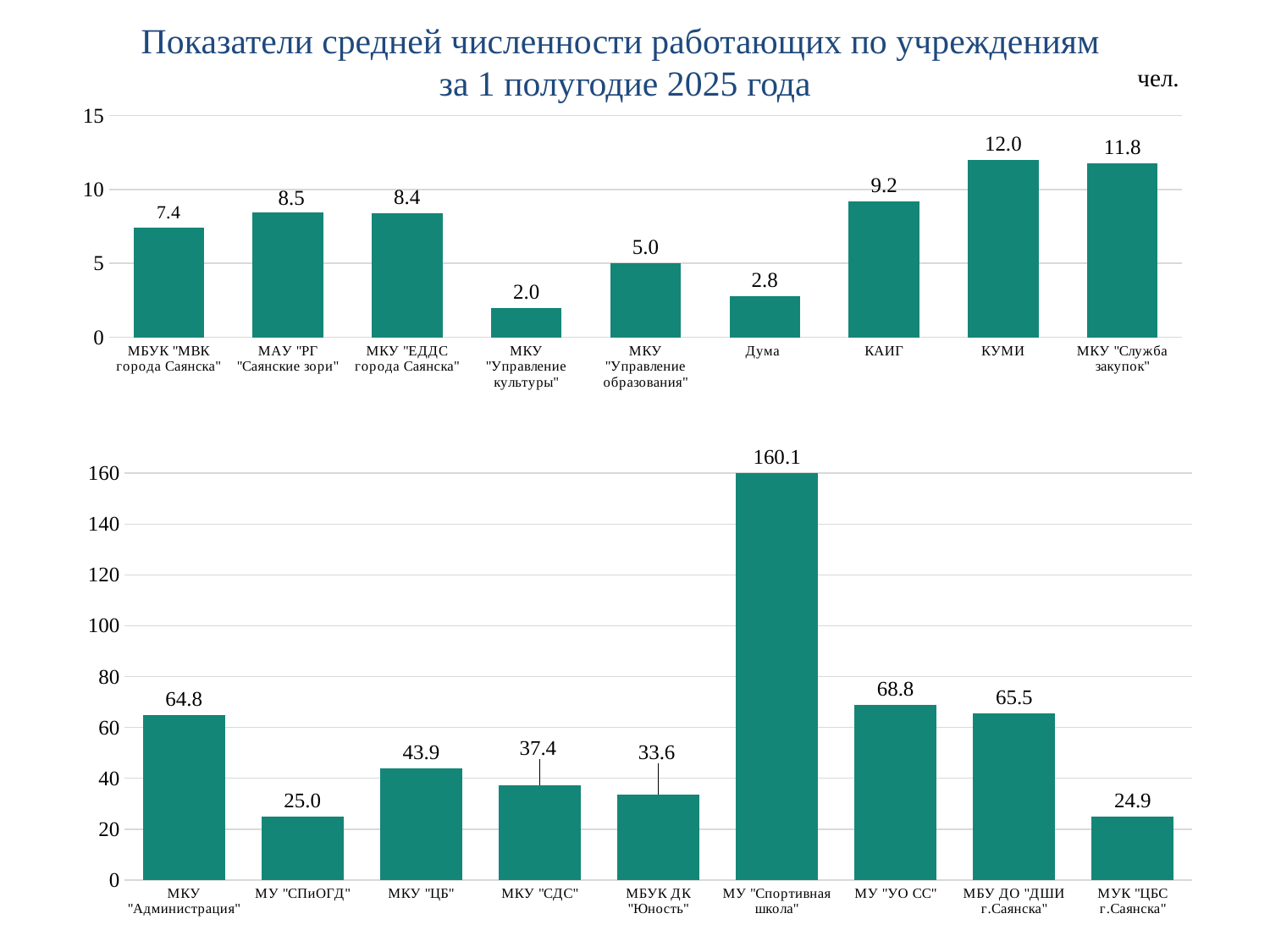
In the top chart, which category has the lowest value? МКУ "Управление культуры" In the bottom chart, what is the value for МУ "Спортивная школа"? 160.1 In the bottom chart, which category has the highest value? МУ "Спортивная школа" In the bottom chart, what is the difference between the values for МКУ "ЦБ" and МКУ "СДС"? 6.5 What unit is indicated at the top right of the slide? чел. In the top chart, how many categories are shown? 9 In the top chart, is the value for МКУ "Служба закупок" greater or less than 10? greater In the bottom chart, which is larger: the value for МКУ "Администрация" or МУ "УО СС"? МУ "УО СС" In the top chart, what is the value for КУМИ? 12.0 In the bottom chart, which category has the lowest value? МУК "ЦБС г.Саянска" What kind of chart is the bottom chart? bar chart In the top chart, what is the difference between the values for КАИГ and Дума? 6.4